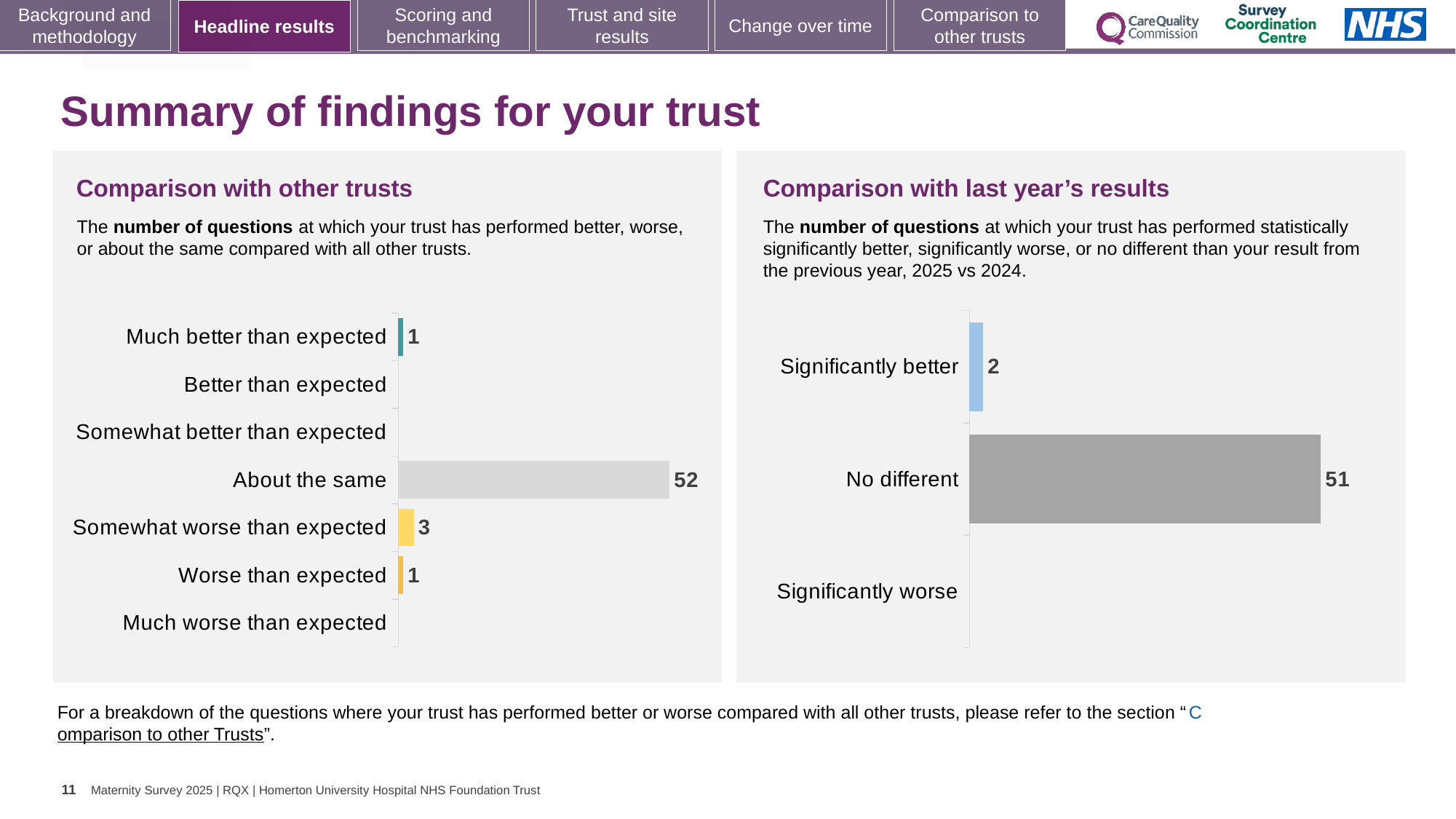
In the 'Comparison with other trusts' chart, how many questions are 'About the same'? 52 In the 'Comparison with last year's results' chart, how many questions are 'No different'? 51 In the 'Comparison with last year's results' chart, what is the difference between 'No different' and 'Significantly better'? 49 In the 'Comparison with last year's results' chart, how many questions are 'Significantly better'? 2 In the 'Comparison with other trusts' chart, what is the difference between 'About the same' and 'Somewhat worse than expected'? 49 In the 'Comparison with other trusts' chart, how many questions are 'Much better than expected'? 1 In the 'Comparison with last year's results' chart, which category has the lowest number of questions? Significantly worse In the 'Comparison with other trusts' chart, how many categories are listed on the axis? 7 What type of chart is the 'Comparison with other trusts' chart? Bar chart In the 'Comparison with other trusts' chart, which category has the highest number of questions? About the same In the 'Comparison with other trusts' chart, how many questions are 'Somewhat worse than expected'? 3 In the 'Comparison with last year's results' chart, how many categories are listed on the axis? 3